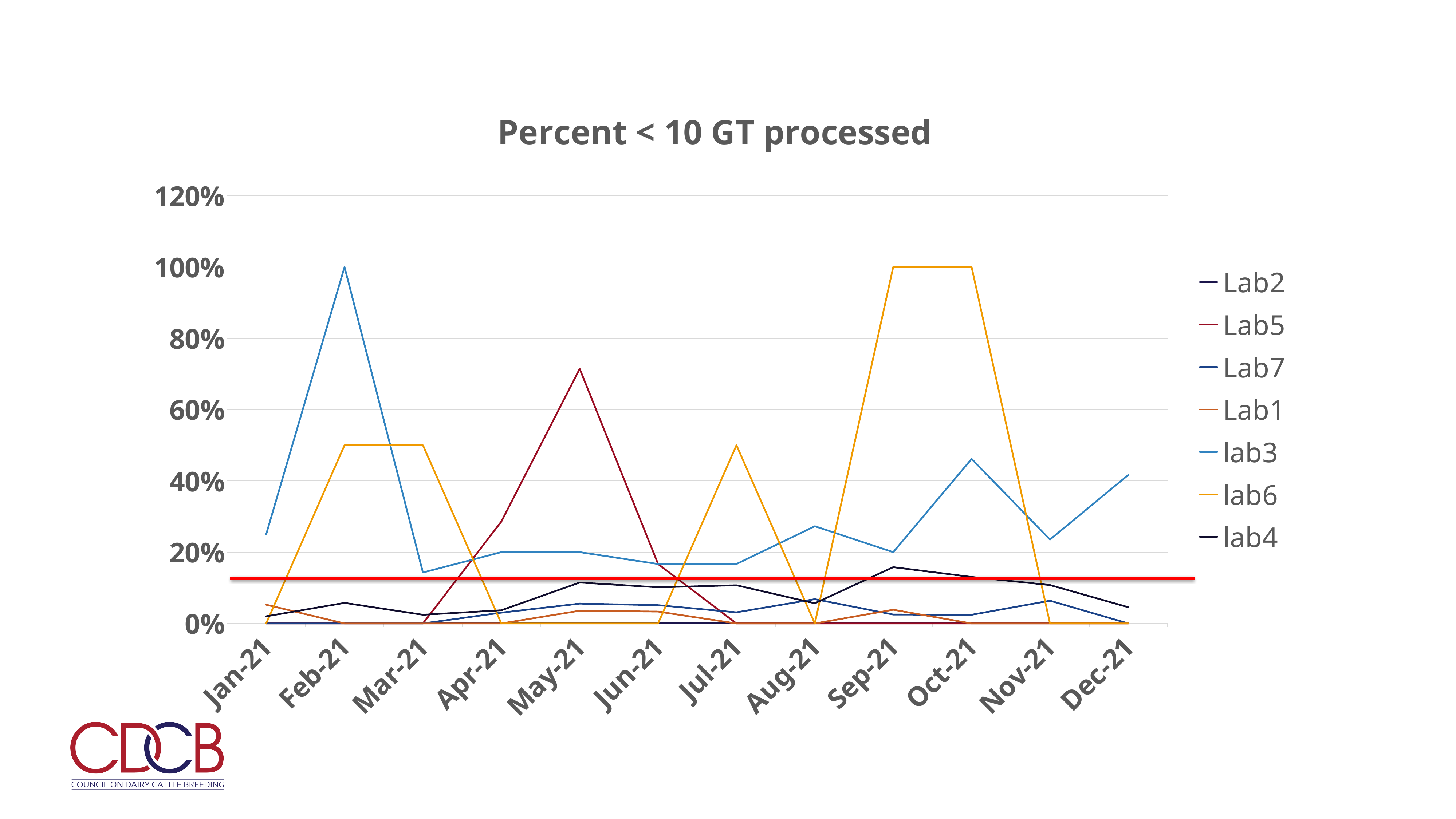
Is the value for lab6 in Jul-21 greater or less than 40%? greater What kind of chart is shown on the slide? line chart How many months are shown along the x axis? 12 What is the value for lab6 in Oct-21? 100% How many series does the legend list? 7 In Oct-21, which is larger: lab6 or lab3? lab6 Which series has the highest value in Sep-21? lab6 What is the value for lab6 in Nov-21? 0% Is the value for Lab5 in May-21 greater or less than 60%? greater Which series has the highest value in Feb-21? lab3 What is the value for lab3 in Feb-21? 100% What is the title of the chart? Percent < 10 GT processed